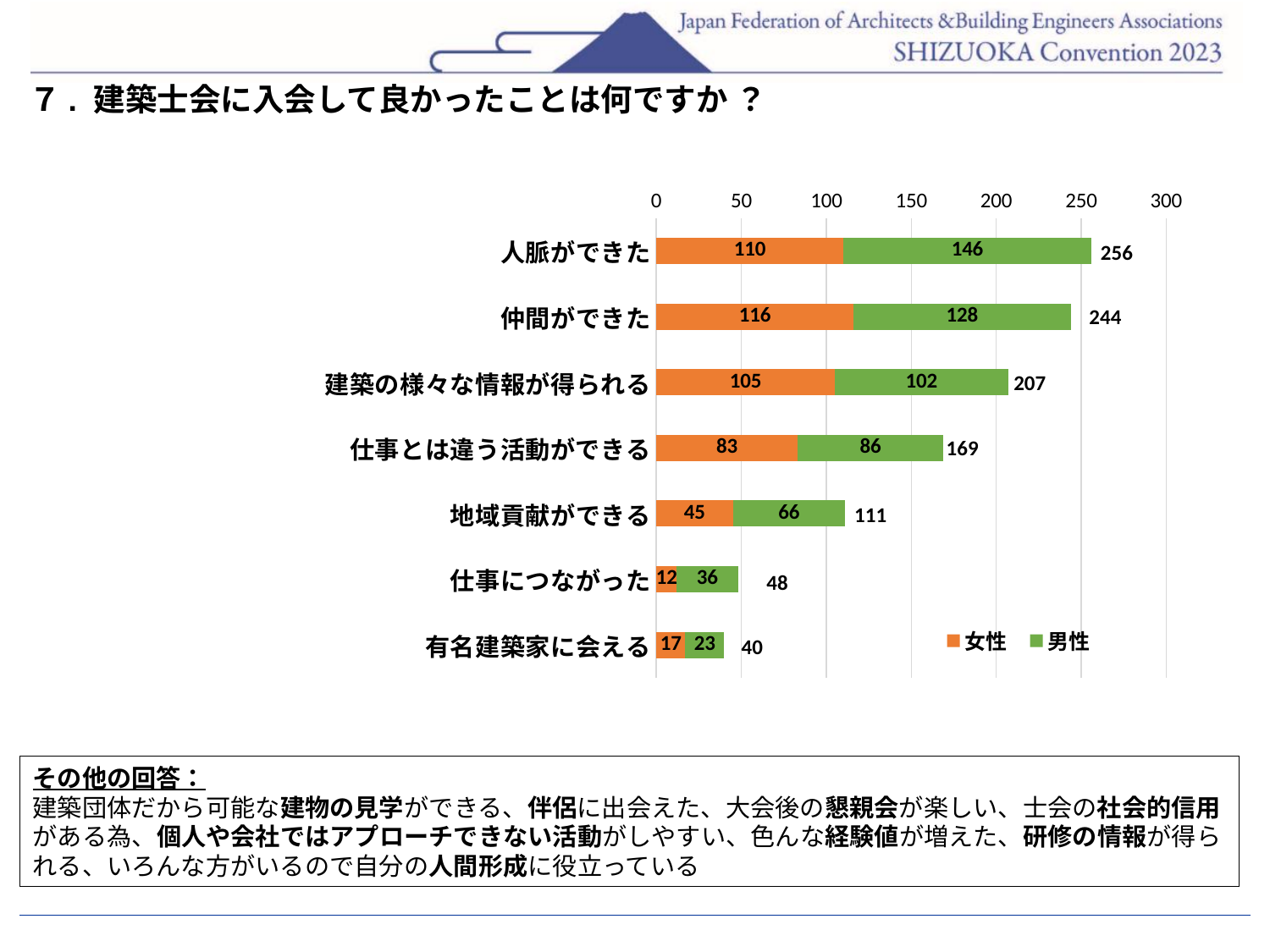
How many series does the legend list? 2 How many categories are shown in the chart? 7 What is the total for the 地域貢献ができる bar? 111 What is the 男性 value for 仕事につながった? 36 Which is larger for 建築の様々な情報が得られる, the 女性 value or the 男性 value? 女性 What is the 女性 value for 人脈ができた? 110 Which colour represents 女性 in the chart? Orange What is the 男性 value for 仲間ができた? 128 Which category has the lowest total? 有名建築家に会える What is the difference between the 男性 and 女性 values for 人脈ができた? 36 What kind of chart is shown on the slide? Stacked bar chart Which category has the highest total? 人脈ができた